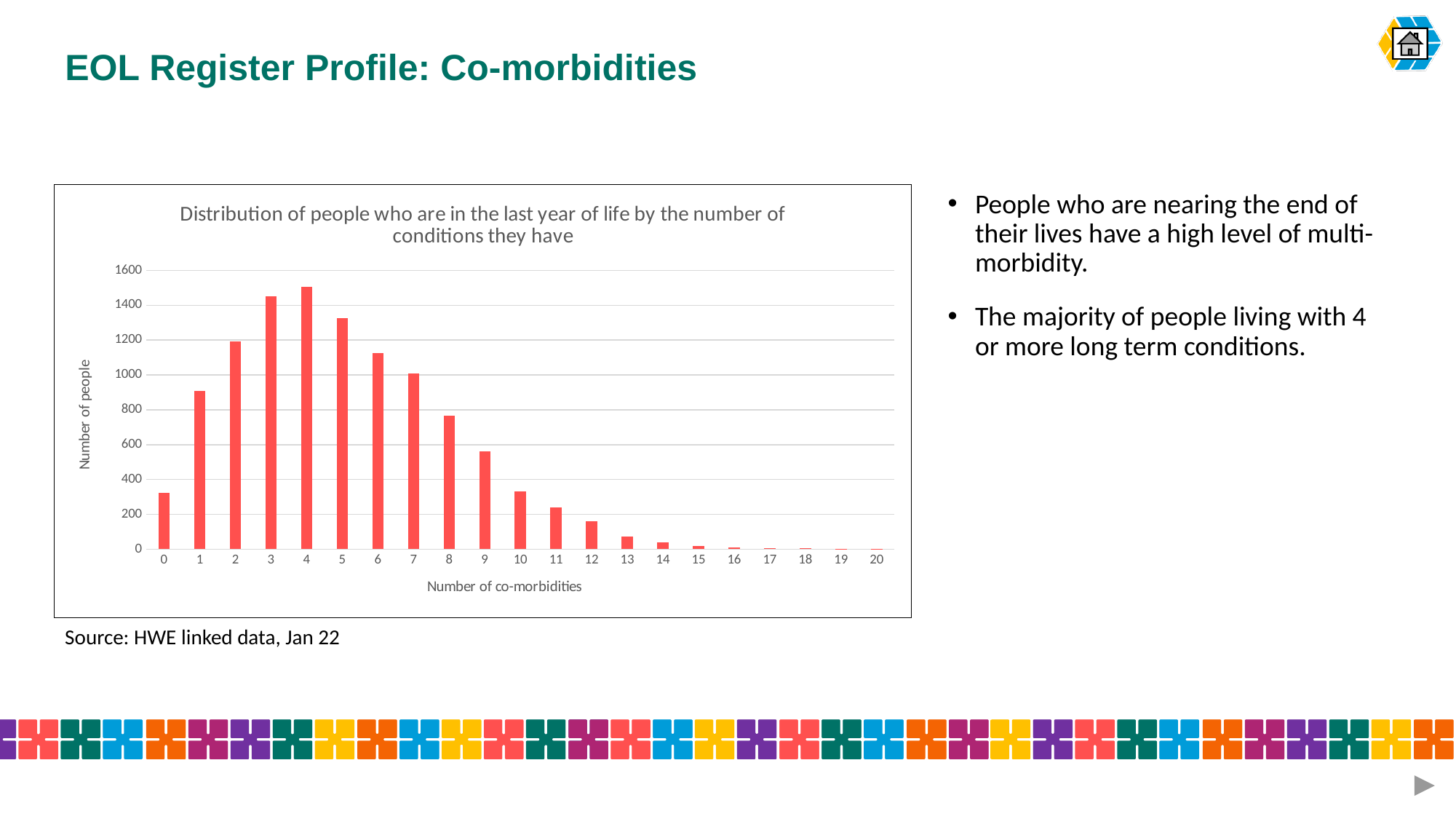
Is the number of people with 0 co-morbidities greater or less than 400? less Is the number of people with 2 co-morbidities greater or less than 1000? greater Is the number of people with 12 co-morbidities greater or less than 200? less What kind of chart is shown on the slide? Bar chart How many co-morbidity categories are shown on the x axis? 21 Do the values rise or fall as the number of co-morbidities increases from 4 to 20? Fall Which has more people: 6 co-morbidities or 8 co-morbidities? 6 co-morbidities Which number of co-morbidities has the highest number of people? 4 What is the label on the y axis of the chart? Number of people Which has more people: 1 co-morbidity or 9 co-morbidities? 1 co-morbidity